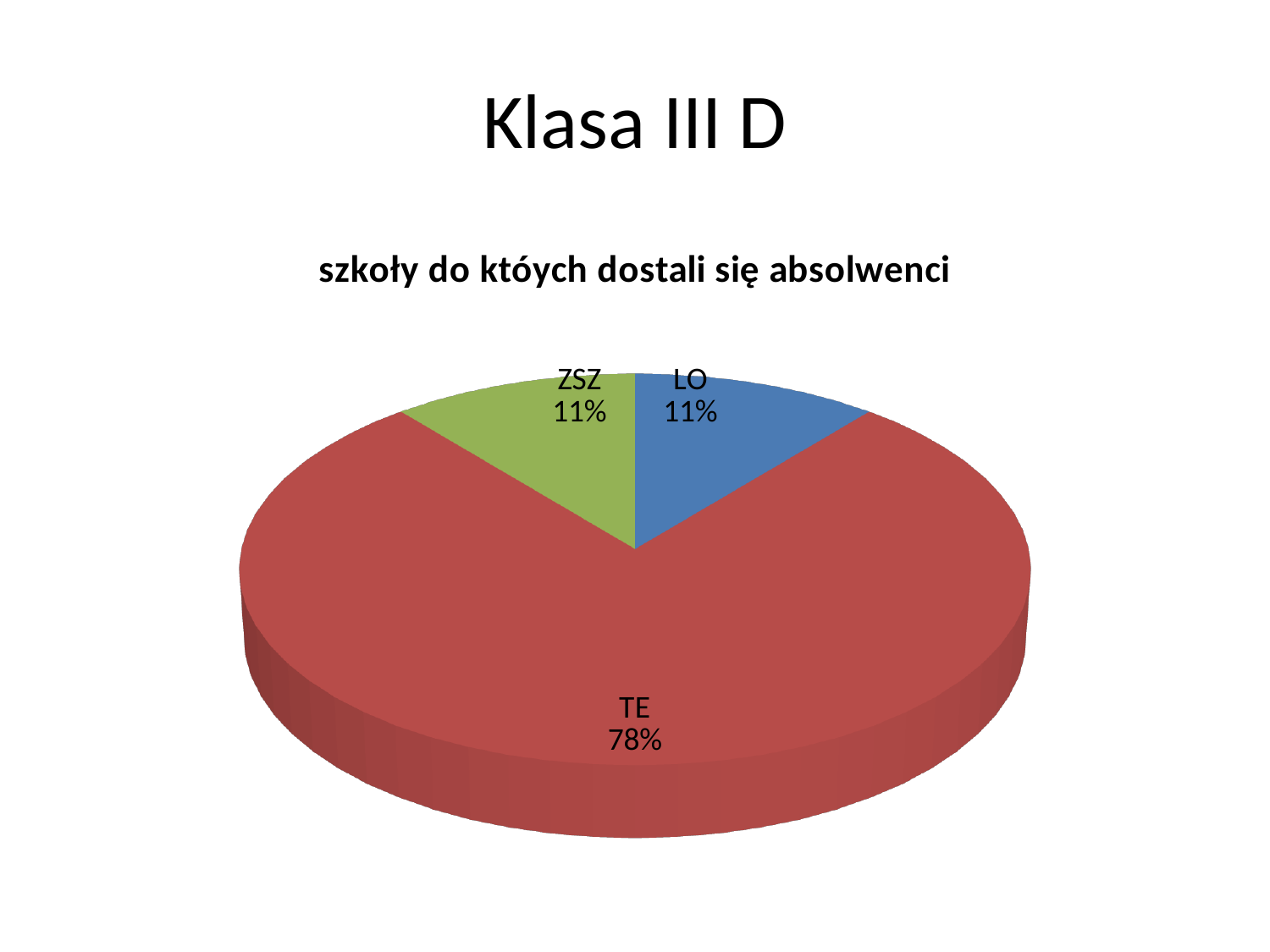
What share of the pie does LO have? 11% What share of the pie does TE have? 78% Which is larger, the TE slice or the ZSZ slice? TE How many slices does the pie chart have? 3 What kind of chart is shown on the slide? pie chart Which category has the largest slice of the pie? TE What share of the pie does ZSZ have? 11% What is the combined share of the LO and ZSZ slices? 22% What colour is the TE slice? red What is the title of the chart? szkoły do któych dostali się absolwenci What is the difference in percentage points between the TE slice and the LO slice? 67